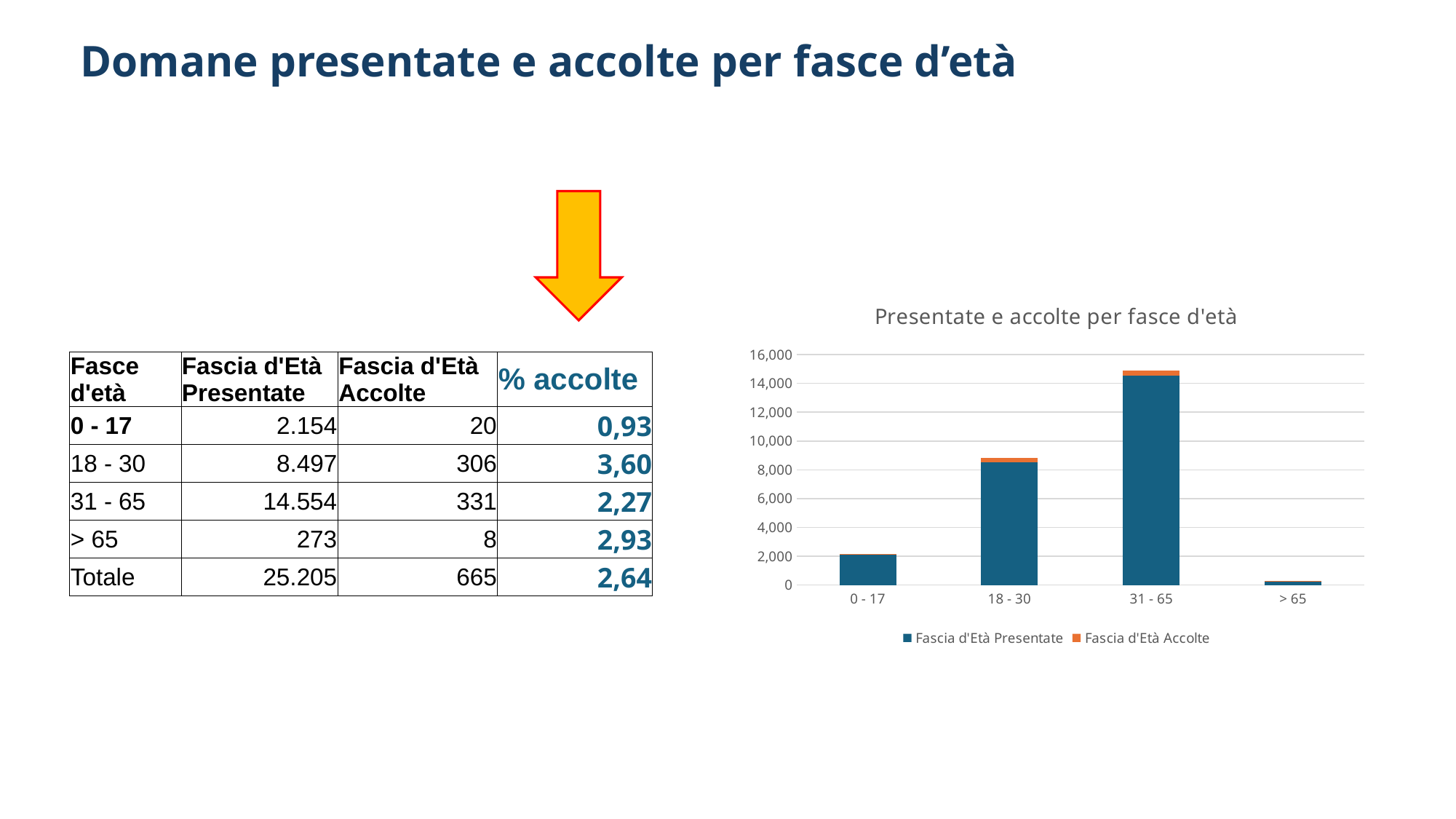
Is the Fascia d'Età Presentate value for 18 - 30 greater or less than 10,000? less Do the Fascia d'Età Presentate values rise or fall from 31 - 65 to > 65? fall How many series does the chart legend list? 2 Is the Fascia d'Età Presentate value for > 65 greater or less than 2,000? less Is the Fascia d'Età Presentate value for 31 - 65 greater or less than 14,000? greater What kind of chart is shown on the slide? bar chart Which age category has the lowest Fascia d'Età Presentate bar in the chart? > 65 Which age category has the highest Fascia d'Età Presentate bar in the chart? 31 - 65 What is the title of the chart? Presentate e accolte per fasce d'età How many age categories are shown on the x axis of the chart? 4 Which is larger in the chart, the Fascia d'Età Presentate bar for 18 - 30 or for 0 - 17? 18 - 30